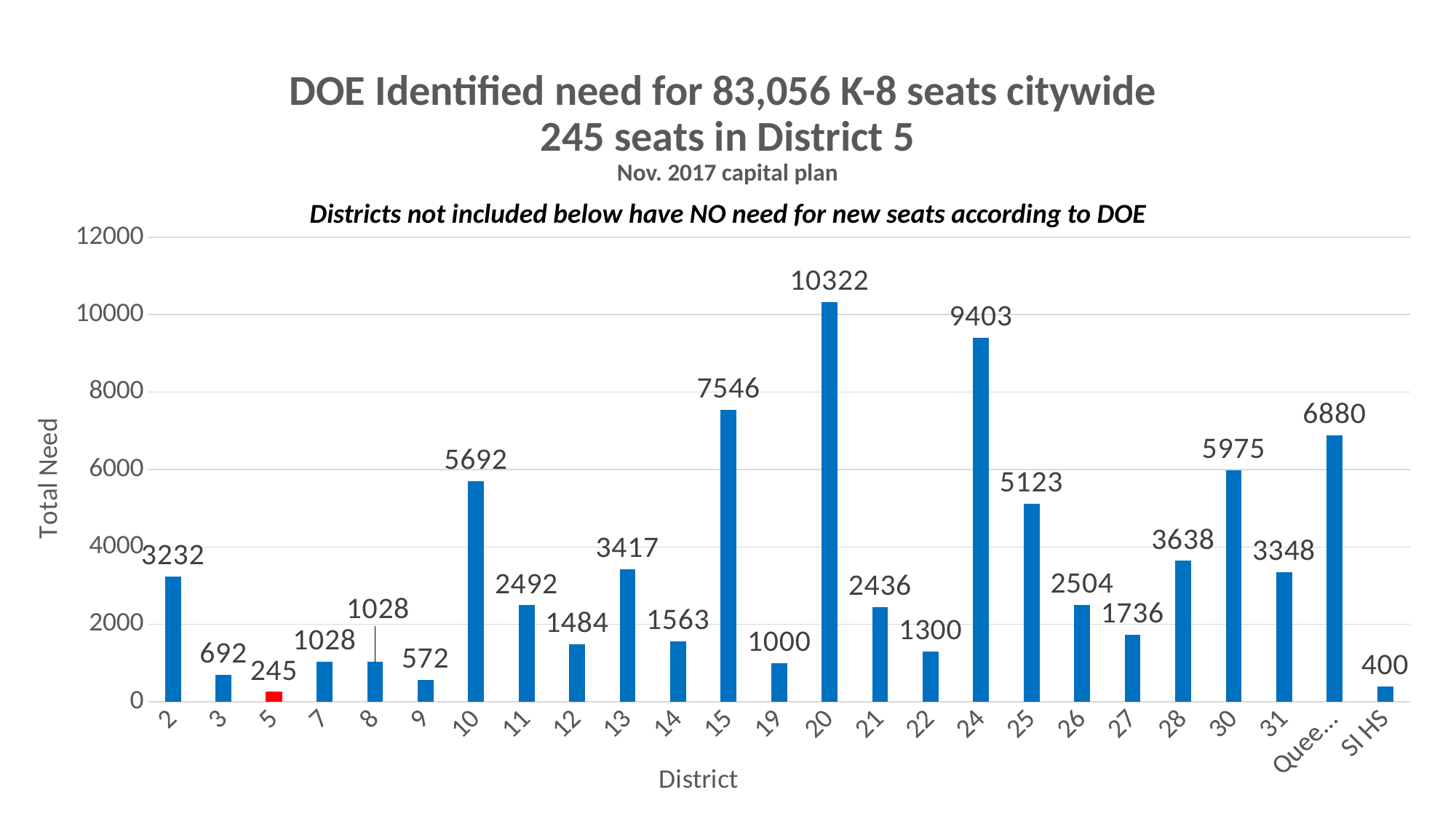
Is the value for District 28 greater or less than 4000? less Which has a larger total need, District 10 or District 30? District 30 Which district has the highest total need? 20 What is the total need for District 15? 7546 What is the total need for SI HS? 400 What type of chart is shown on the slide? bar chart What is the total need for District 20? 10322 Which bar is coloured red instead of blue? District 5 Which district has the lowest total need? 5 What is the difference in total need between District 24 and District 25? 4280 What is the total need for District 5? 245 How many districts are shown on the x axis? 25